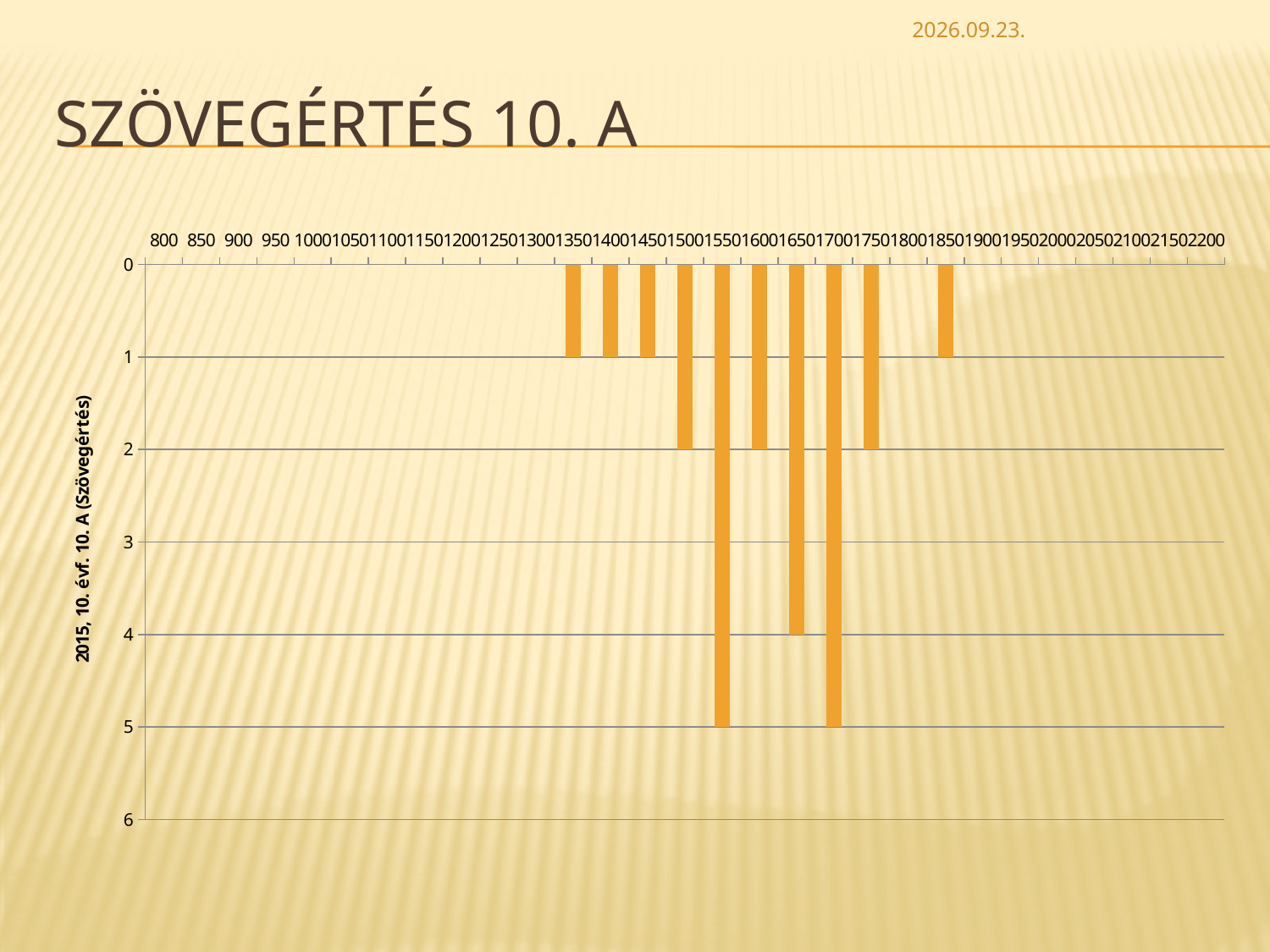
What is the value of the bar at 1500? 2 What is the difference between the bar at 1700 and the bar at 1750? 3 What is the value of the bar at 1750? 2 What is the value of the bar at 1550? 5 What is the value of the bar at 1650? 4 How many bars are plotted in the chart? 10 Which is larger, the bar at 1650 or the bar at 1600? 1650 What is the difference between the bar at 1650 and the bar at 1350? 3 What is the label of the vertical axis? 2015, 10. évf. 10. A (Szövegértés) What kind of chart is shown on the slide? bar chart What is the value of the bar at 1850? 1 Which is larger, the bar at 1700 or the bar at 1450? 1700